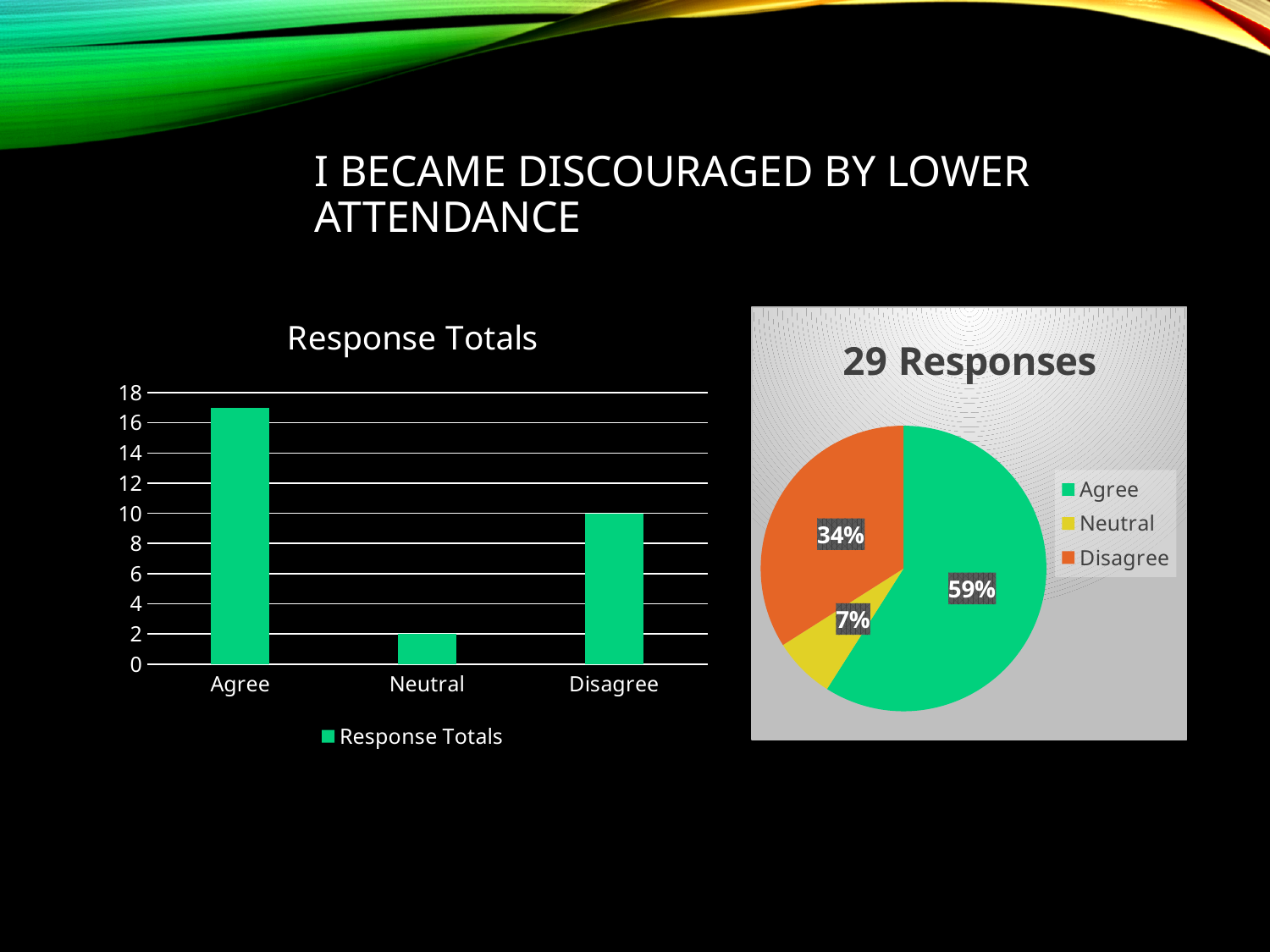
In the Response Totals bar chart, which is larger, the value for Disagree or the value for Neutral? Disagree In the Response Totals bar chart, which category has the highest value? Agree What is the title of the pie chart on the right of the slide? 29 Responses What kind of chart is the chart on the left of the slide? bar chart In the 29 Responses pie chart, what share of the pie is Agree? 59% In the 29 Responses pie chart, what share of the pie is Neutral? 7% In the Response Totals bar chart, which category has the lowest value? Neutral In the Response Totals bar chart, what is the value for Neutral? 2 In the 29 Responses pie chart, what is the difference between the Agree share and the Disagree share? 25% How many categories are shown in the Response Totals bar chart? 3 In the Response Totals bar chart, is the value for Agree greater or less than 16? greater In the Response Totals bar chart, what is the value for Disagree? 10